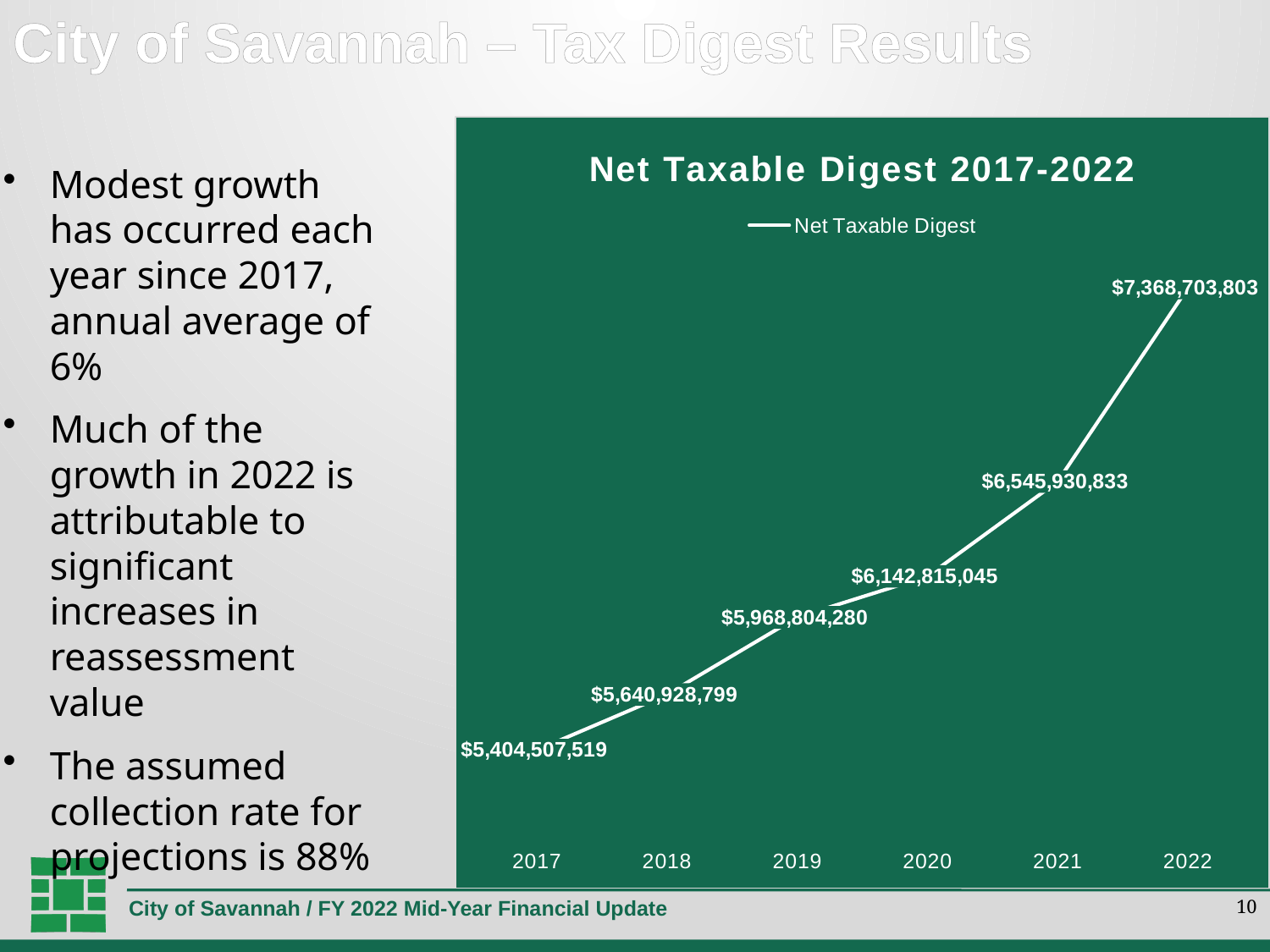
What is the value of the Net Taxable Digest for 2020? $6,142,815,045 How many years are plotted on the chart? 6 Which is larger, the Net Taxable Digest in 2018 or in 2019? 2019 What is the difference between the Net Taxable Digest in 2022 and in 2021? $822,772,970 How many series does the legend list? 1 Which year has the lowest Net Taxable Digest? 2017 What is the value of the Net Taxable Digest for 2017? $5,404,507,519 Which year has the highest Net Taxable Digest? 2022 Does the Net Taxable Digest rise or fall from 2017 to 2022? Rise What is the value of the Net Taxable Digest for 2022? $7,368,703,803 What is the difference between the Net Taxable Digest in 2020 and in 2019? $174,010,765 What kind of chart is shown on the slide? Line chart